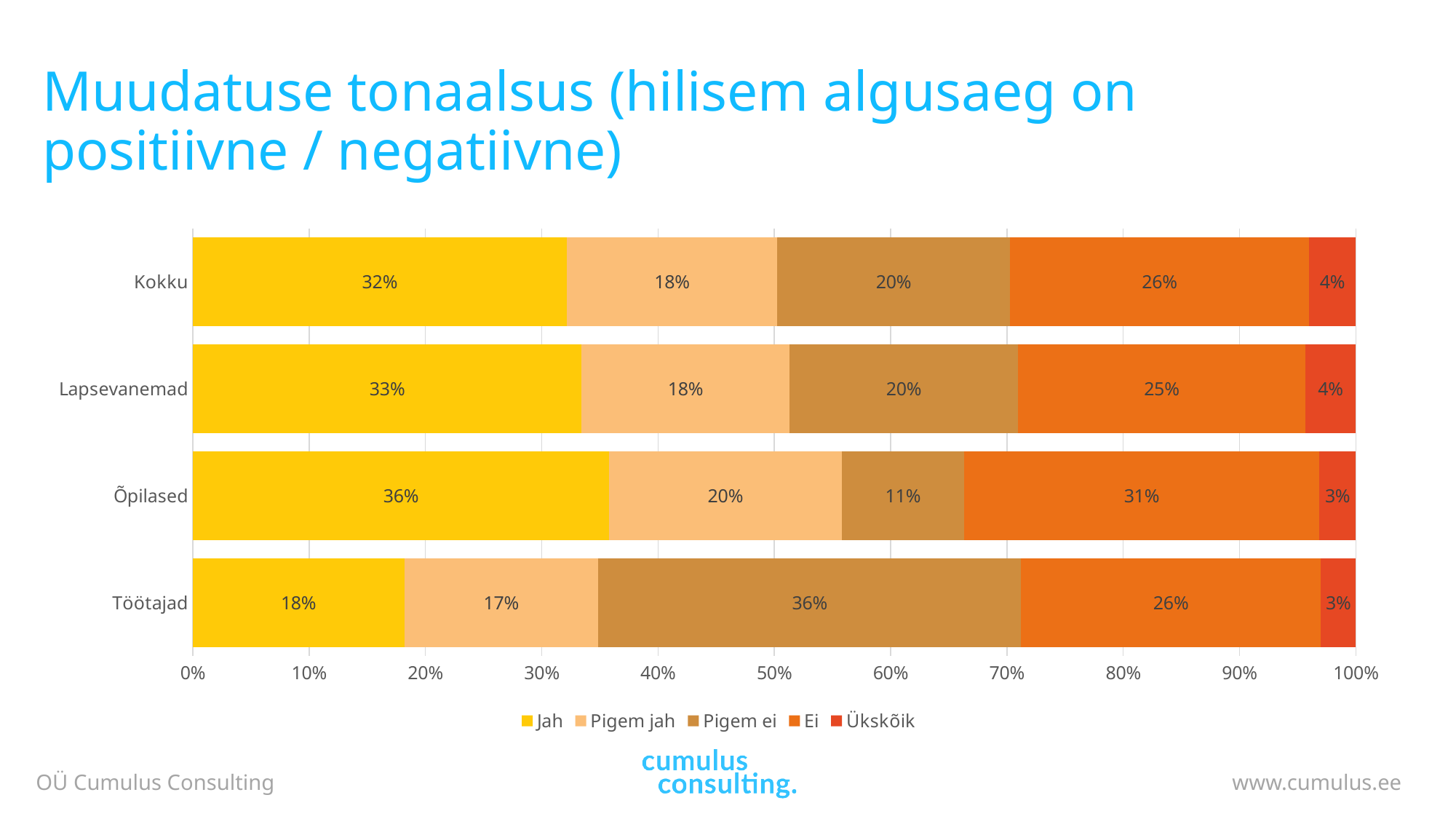
What is the total of the "Jah" and "Pigem jah" values for Lapsevanemad? 51% What is the value of "Ei" for Lapsevanemad? 25% What kind of chart is shown on the slide? Stacked bar chart What is the value of "Ükskõik" for Kokku? 4% What is the value of "Pigem ei" for Töötajad? 36% Which category has the lowest "Jah" value? Töötajad Which category has the highest "Jah" value? Õpilased How many series does the legend list? 5 Which is larger: the "Pigem ei" value for Töötajad or the "Pigem ei" value for Õpilased? Töötajad How many categories are shown on the y axis? 4 What is the value of "Jah" for Õpilased? 36% What is the difference between the "Ei" value for Õpilased and the "Ei" value for Kokku? 5%